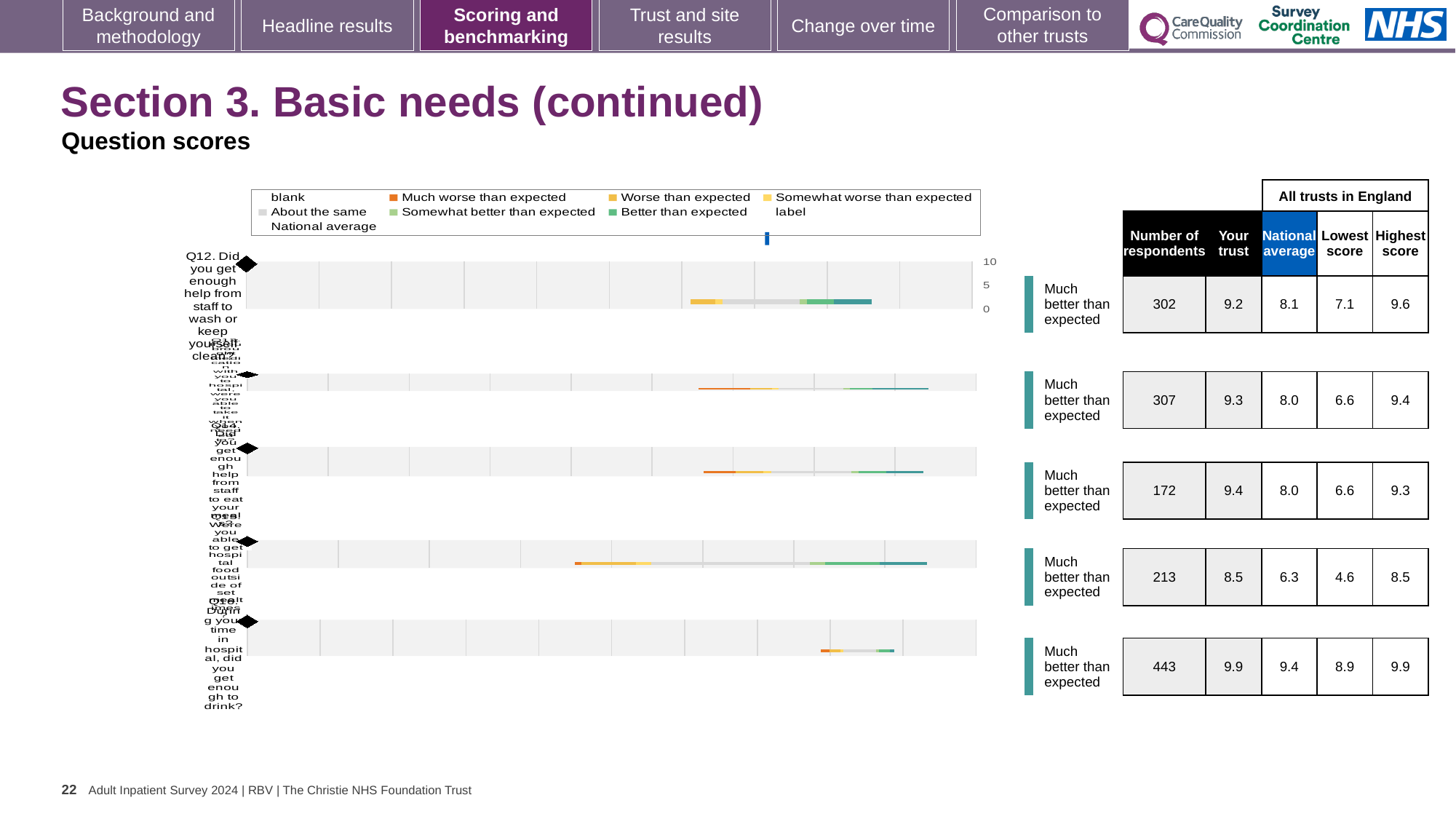
What benchmark category is shown beside every row of the chart? Much better than expected In the table next to the chart, which row has the highest 'Your trust' score? the fifth (bottom) row, 9.9 What kind of chart is shown on the slide? bar chart In the table next to the chart, what is the 'Your trust' score for the first row (Q12)? 9.2 In the table next to the chart, what is the national average for the first row (Q12)? 8.1 In the table next to the chart, what is the number of respondents for the first row (Q12)? 302 Which legend entry is shown in orange? Much worse than expected In the table next to the chart, what is the difference between 'Your trust' and the national average in the first row (Q12)? 1.1 How many question rows (bars) does the chart show? 5 What is the full label of the first (top) question row in the chart? Q12. Did you get enough help from staff to wash or keep yourself clean? In the table next to the chart, which row has the lowest 'Your trust' score? the fourth row, 8.5 How many entries does the chart legend list? 9